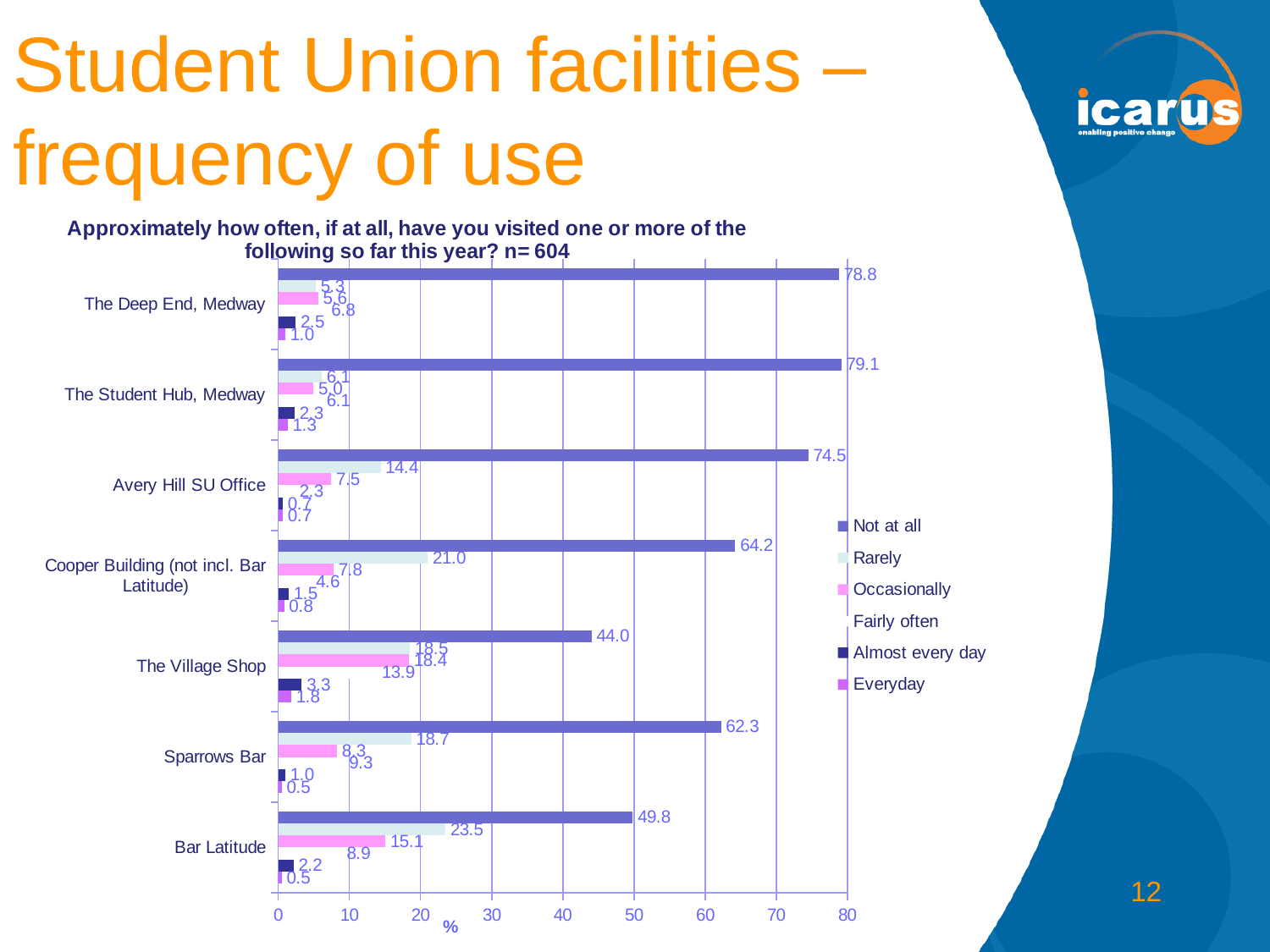
How many facilities (categories) are shown on the chart? 7 Which facility has the highest 'Not at all' value? The Student Hub, Medway What is the 'Not at all' value for The Village Shop? 44.0 Is the 'Not at all' value for Avery Hill SU Office greater or less than 70? greater What is the 'Rarely' value for Bar Latitude? 23.5 How many series does the legend list? 6 What is the 'Occasionally' value for Bar Latitude? 15.1 Which facility has the lowest 'Not at all' value? The Village Shop What is the label on the horizontal axis of the chart? % Which has the larger 'Rarely' value, Cooper Building (not incl. Bar Latitude) or Avery Hill SU Office? Cooper Building (not incl. Bar Latitude) What kind of chart is shown on the slide? bar chart What is the difference between the 'Not at all' values for Cooper Building (not incl. Bar Latitude) and Sparrows Bar? 1.9